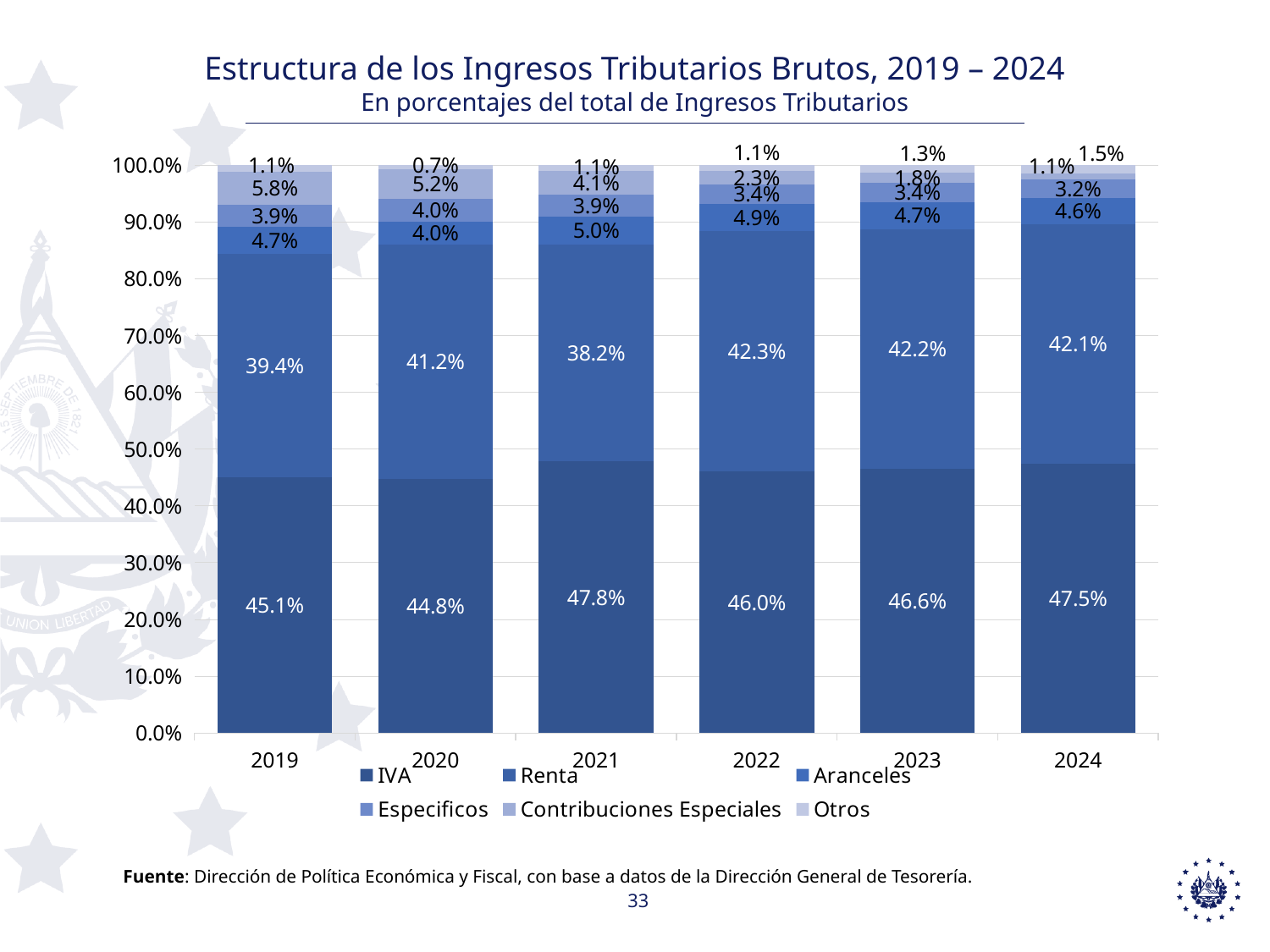
What type of chart is shown on the slide? Stacked bar chart How many years are shown on the x axis? 6 What is the Aranceles share in 2020? 4.0% How many series does the legend list? 6 In 2019, which is larger, the IVA share or the Renta share? IVA What is the Contribuciones Especiales share in 2019? 5.8% What is the Renta share in 2022? 42.3% What is the difference between the IVA share in 2021 and in 2020? 3.0 percentage points What is the subtitle of the chart? En porcentajes del total de Ingresos Tributarios What is the IVA share in 2021? 47.8% In which year is the IVA share highest? 2021 In which year is the Renta share lowest? 2021